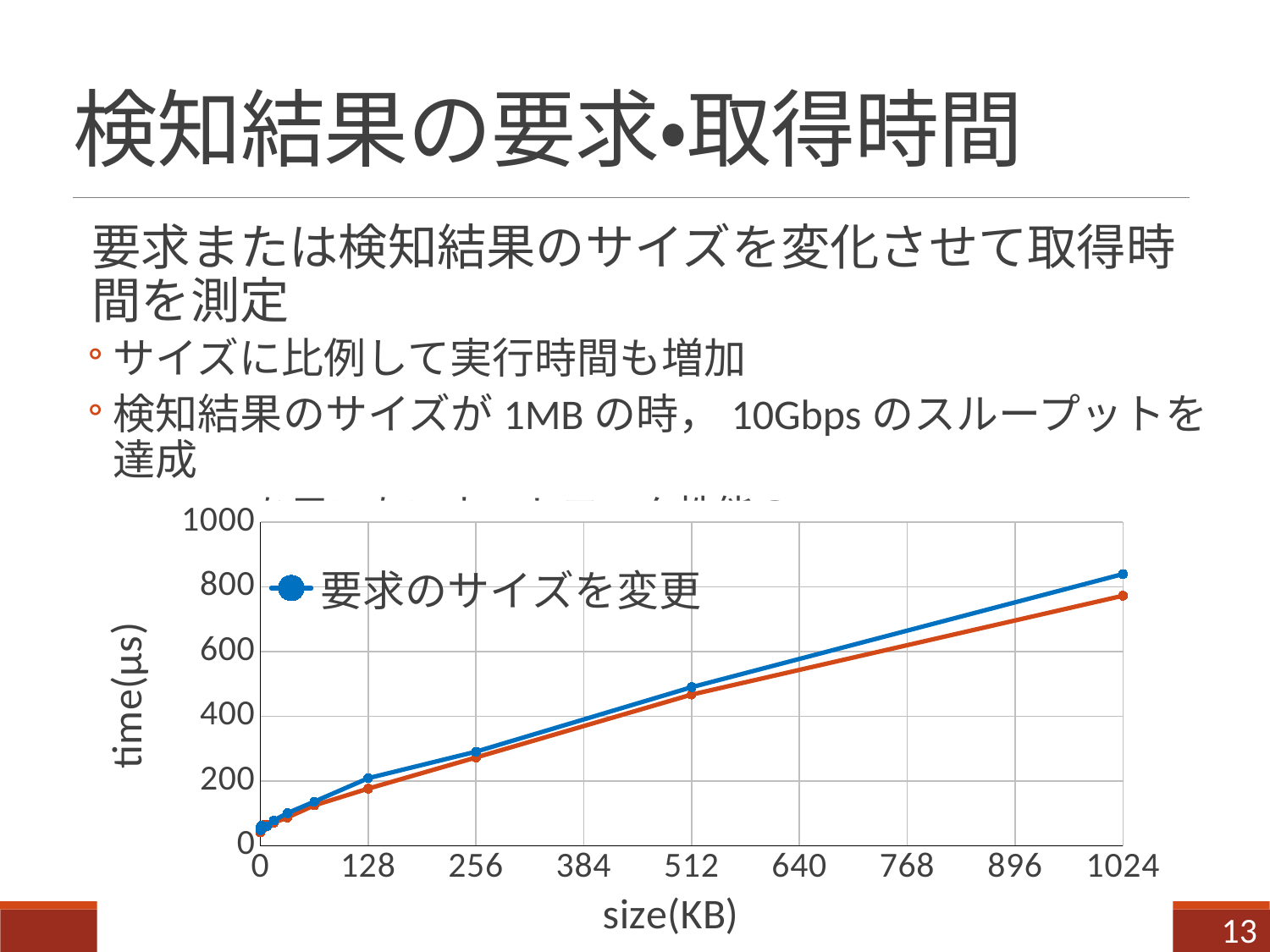
Is the value of the orange line at size 128 KB greater or less than 200? less Is the value of the orange line at size 512 KB greater or less than 600? less At size 1024 KB, is the 要求のサイズを変更 line above or below the orange line? above Is the value of the 要求のサイズを変更 line at size 256 KB greater or less than 200? greater What is the title of the y axis? time(μs) How many tick labels are shown on the x axis? 9 Do the plotted values rise or fall as size(KB) increases along the x axis? rise What kind of chart is shown on the slide? line chart What is the title of the x axis? size(KB)